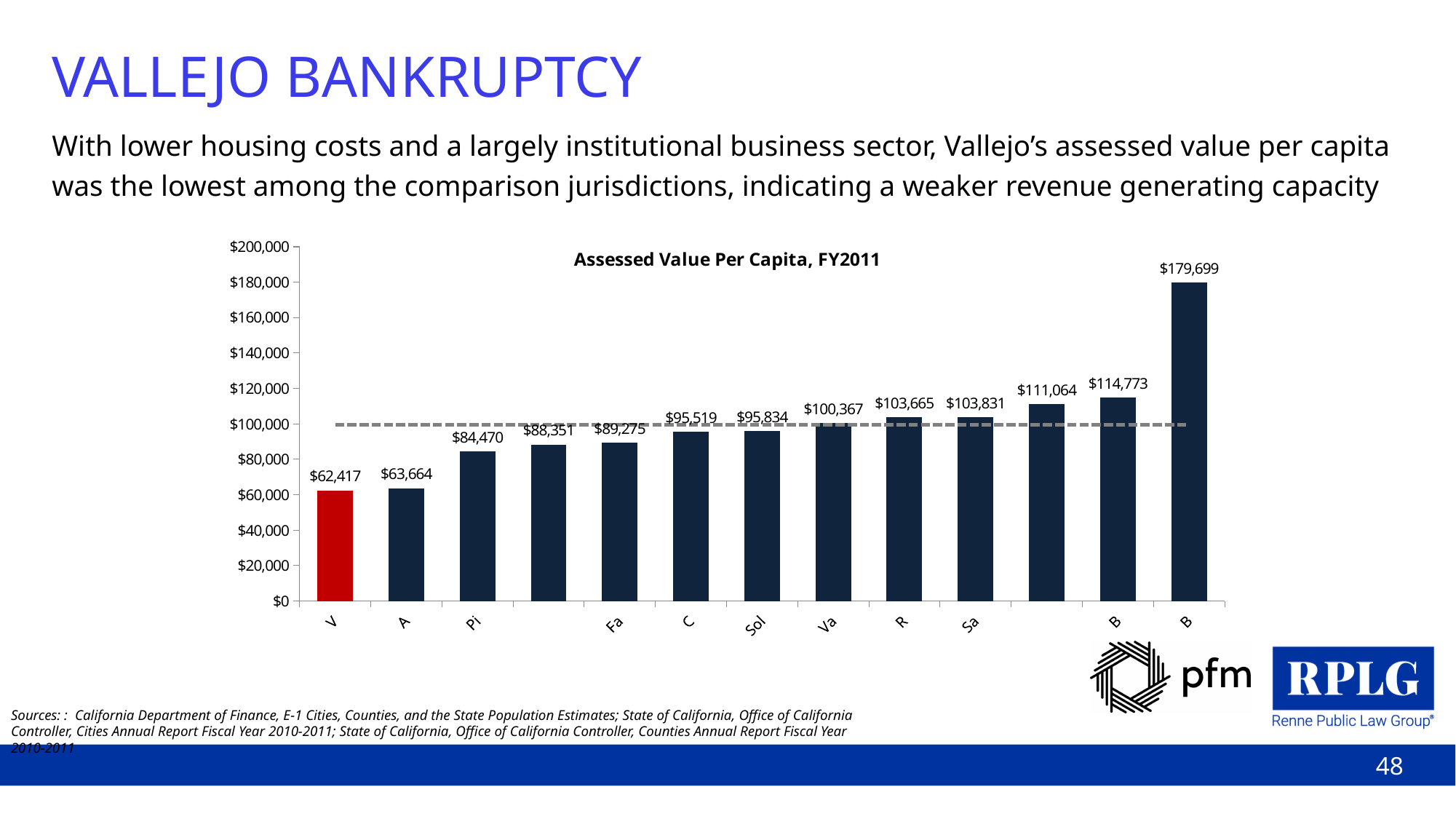
What is the difference between the highest and lowest bars in the chart? $117,282 What is the value of the second-lowest bar in the chart? $63,664 What kind of chart is shown on the slide? bar chart How many bars have values greater than $100,000? 6 What is the difference between the two highest bars in the chart? $64,926 How many bars are plotted in the chart? 13 What is the title of the chart? Assessed Value Per Capita, FY2011 What is the value of the red bar in the chart? $62,417 What is the value of the highest bar in the chart? $179,699 What is the value of the lowest bar in the chart? $62,417 Do the bar values generally rise or fall from left to right along the x axis? rise What is the difference between the two lowest bars in the chart? $1,247